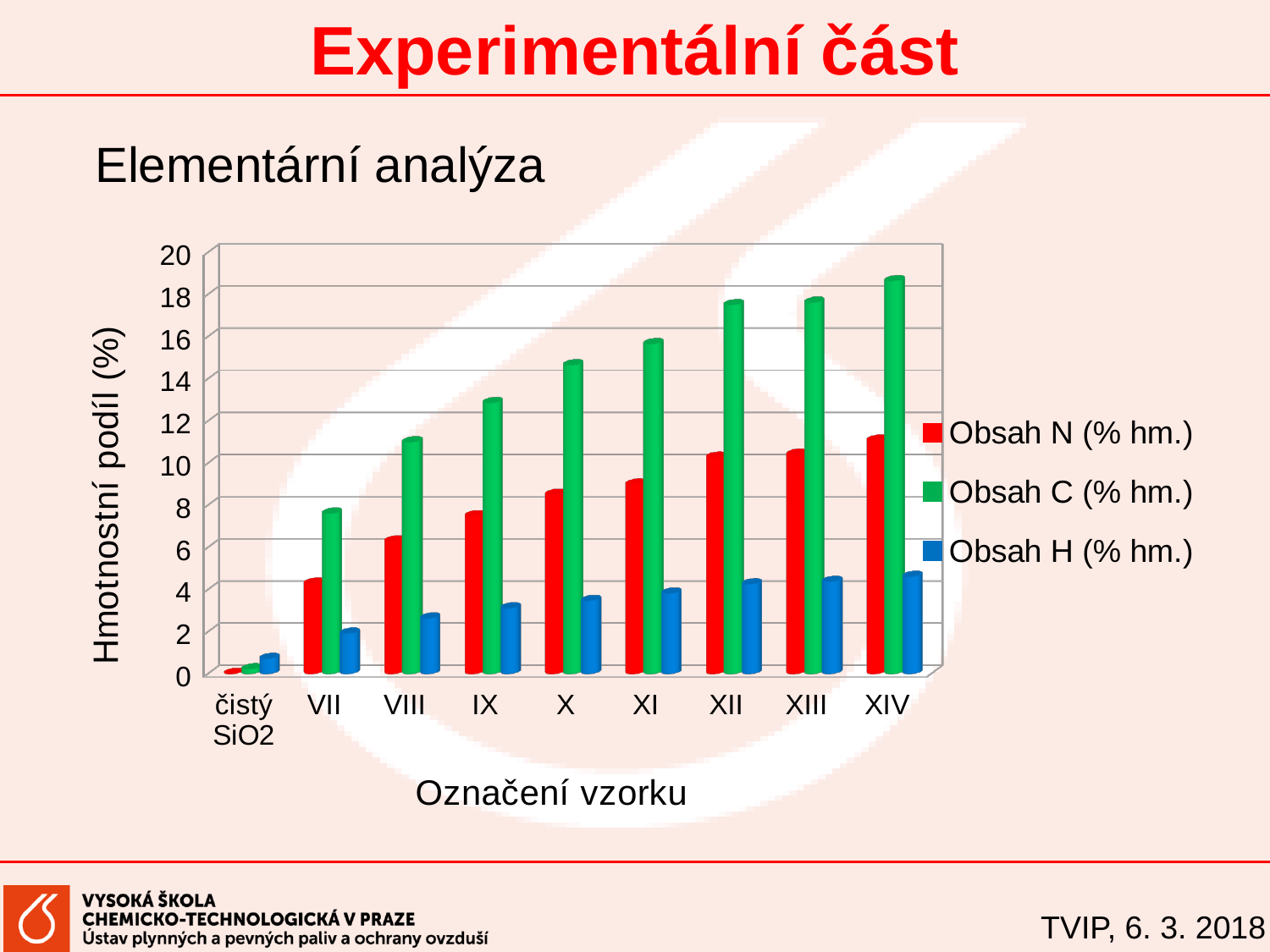
Which sample has the highest value for Obsah C (% hm.)? XIV Which sample has the highest value for Obsah N (% hm.)? XIV Do the values for Obsah C (% hm.) rise or fall from čistý SiO2 to XIV along the x axis? rise Is the value for Obsah N (% hm.) for sample XIV greater or less than 10? greater How many sample categories are shown on the x axis? 9 How many series does the legend list? 3 What is the label of the y axis? Hmotnostní podíl (%) Is the value for Obsah H (% hm.) for sample VII greater or less than 4? less What kind of chart is shown on the slide? bar chart For sample X, which is larger: Obsah C (% hm.) or Obsah N (% hm.)? Obsah C (% hm.) Is the value for Obsah C (% hm.) for sample XIV greater or less than 16? greater Which sample has the lowest value for Obsah C (% hm.)? čistý SiO2